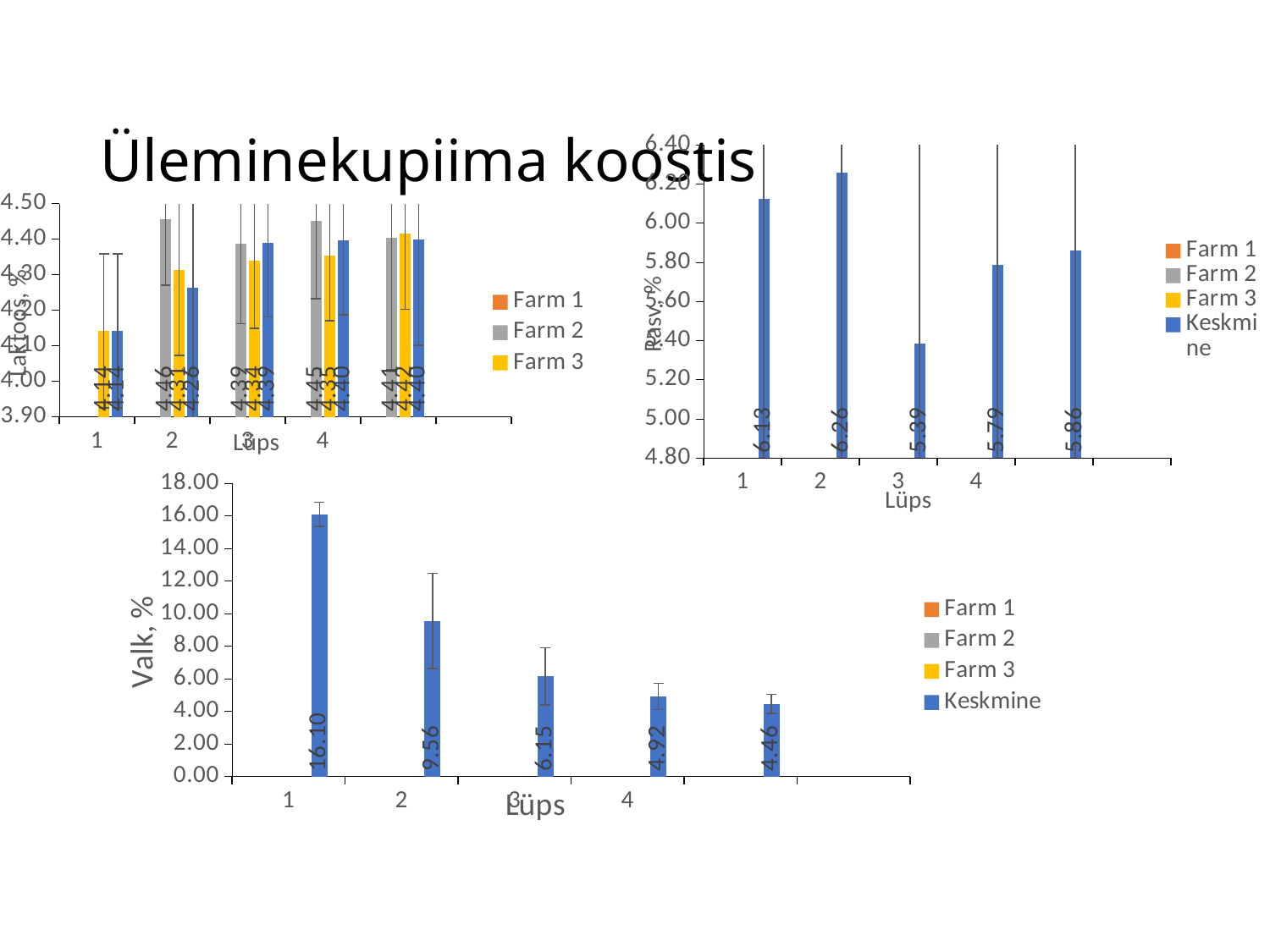
In the Rasv, % chart at the top right, what is the difference between the values for Lüps 2 and Lüps 3? 0.87 In the Valk, % chart at the bottom, how many bars are plotted? 5 In the Rasv, % chart at the top right, what is the value for Lüps 2? 6.26 In the Valk, % chart at the bottom, do the values rise or fall from left to right along the x axis? fall In the Rasv, % chart at the top right, is the value for Lüps 1 greater or less than 6.00? greater In the Valk, % chart at the bottom, what is the difference between the values for Lüps 1 and Lüps 2? 6.54 In the Laktoos, % chart at the top left, what is the label of the x axis? Lüps In the Valk, % chart at the bottom, which Lüps has the highest value? 1 In the Rasv, % chart at the top right, which Lüps has the lowest value? 3 In the Valk, % chart at the bottom, how many entries does the legend list? 4 What kind of chart is the Valk, % chart at the bottom of the slide? bar chart In the Valk, % chart at the bottom, what is the value for Lüps 1? 16.10